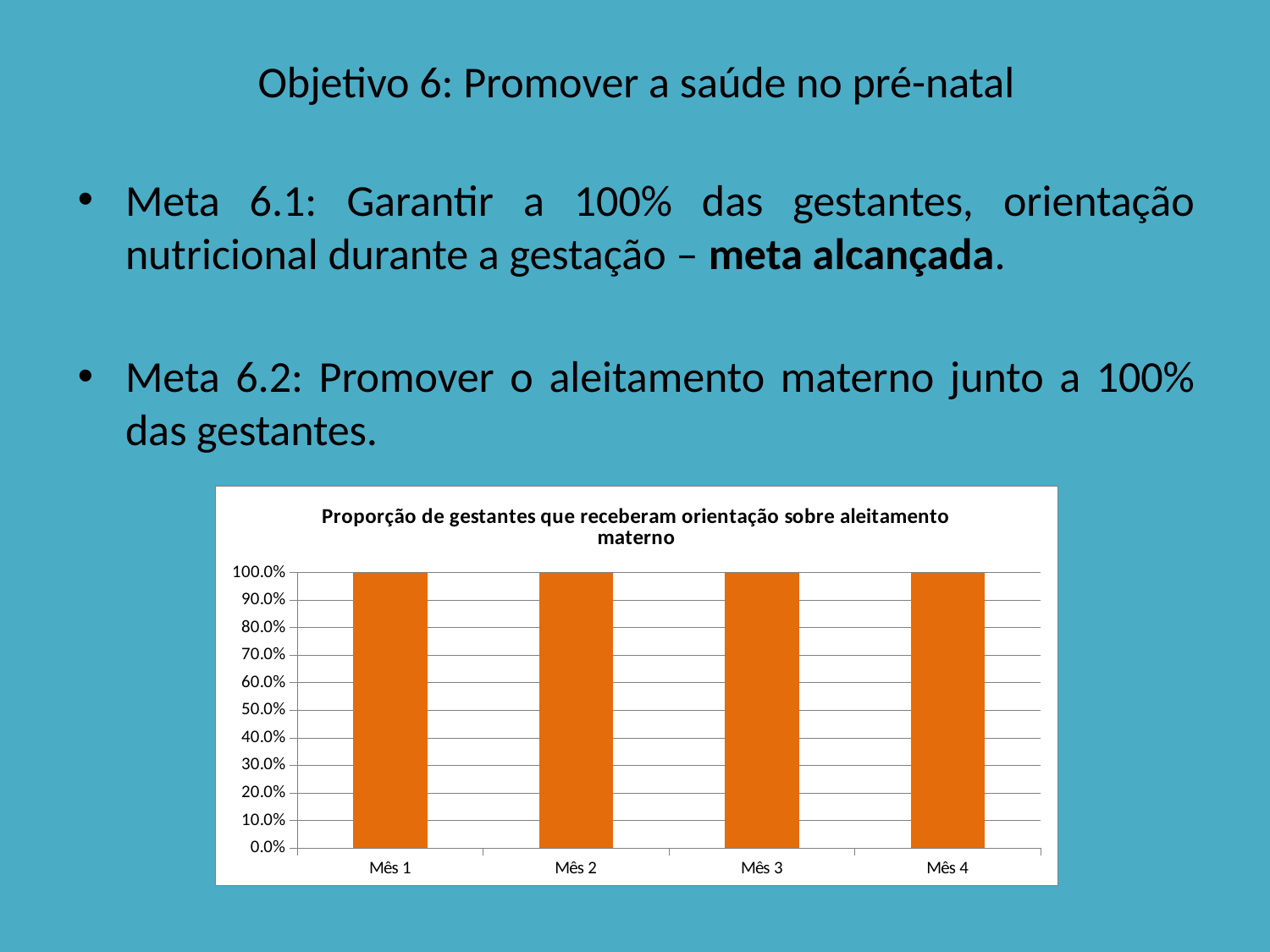
What is the value for Mês 3 in the chart? 100.0% Is the value for Mês 3 greater or less than 90.0%? greater Do the values rise, fall or stay the same from Mês 1 to Mês 4? stay the same What colour are the bars in the chart? orange What is the value for Mês 4 in the chart? 100.0% Is the value for Mês 1 greater or less than 50.0%? greater What is the difference between the values for Mês 1 and Mês 4? 0.0% What type of chart is shown on the slide? bar chart What is the title of the chart? Proporção de gestantes que receberam orientação sobre aleitamento materno What is the value for Mês 2 in the chart? 100.0% What is the value for Mês 1 in the chart? 100.0% How many categories are shown on the x axis of the chart? 4